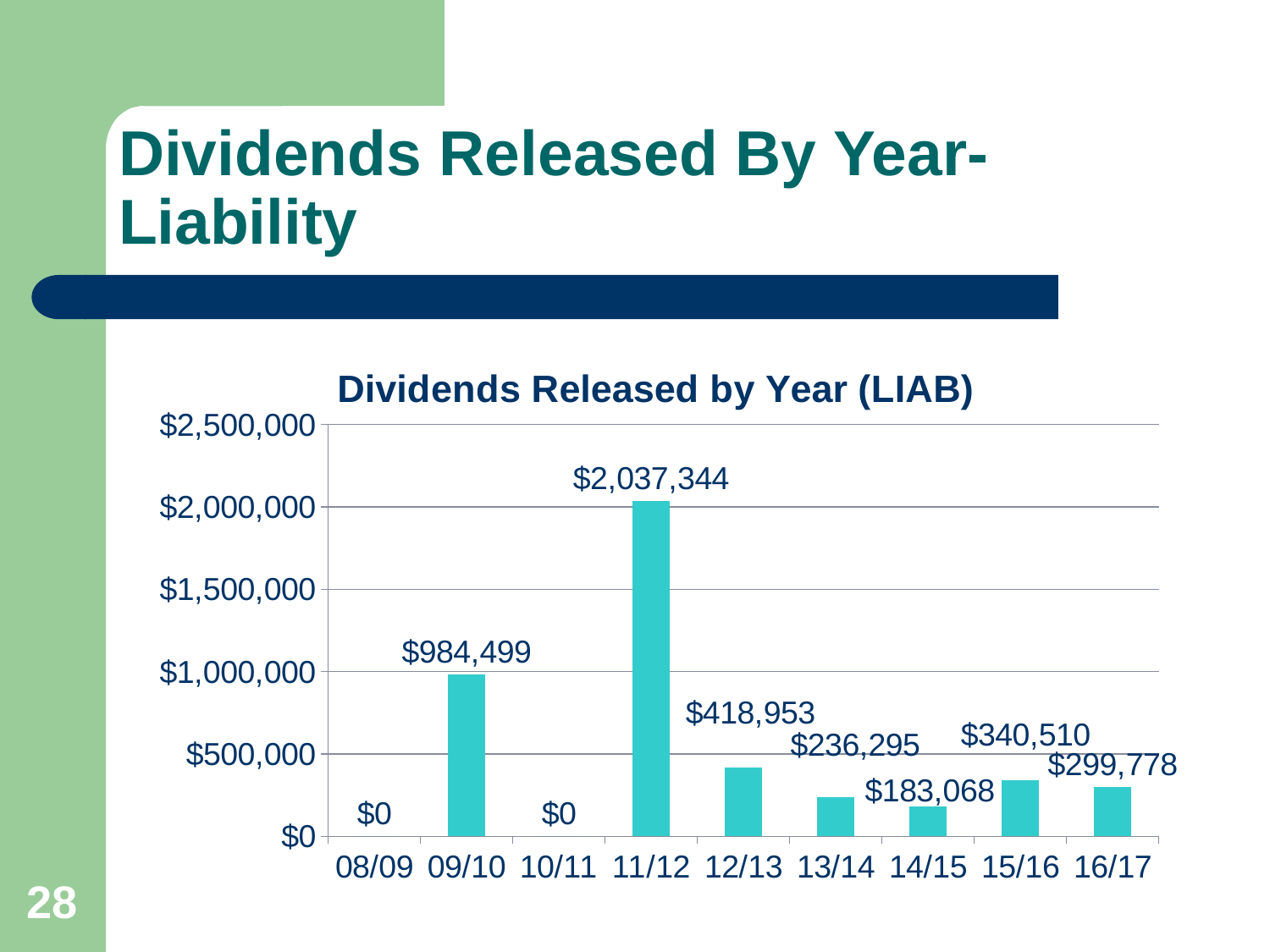
Which year has the highest value? 11/12 Is the value for 12/13 greater or less than $500,000? less Which year has the lowest non-zero value? 14/15 What kind of chart is this? bar chart What is the difference between the values for 11/12 and 09/10? $1,052,845 What is the value for 11/12? $2,037,344 What is the title of the chart? Dividends Released by Year (LIAB) Which is larger, the value for 15/16 or the value for 16/17? 15/16 How many years are shown on the x axis? 9 What is the value for 16/17? $299,778 What is the value for 14/15? $183,068 What is the value for 09/10? $984,499